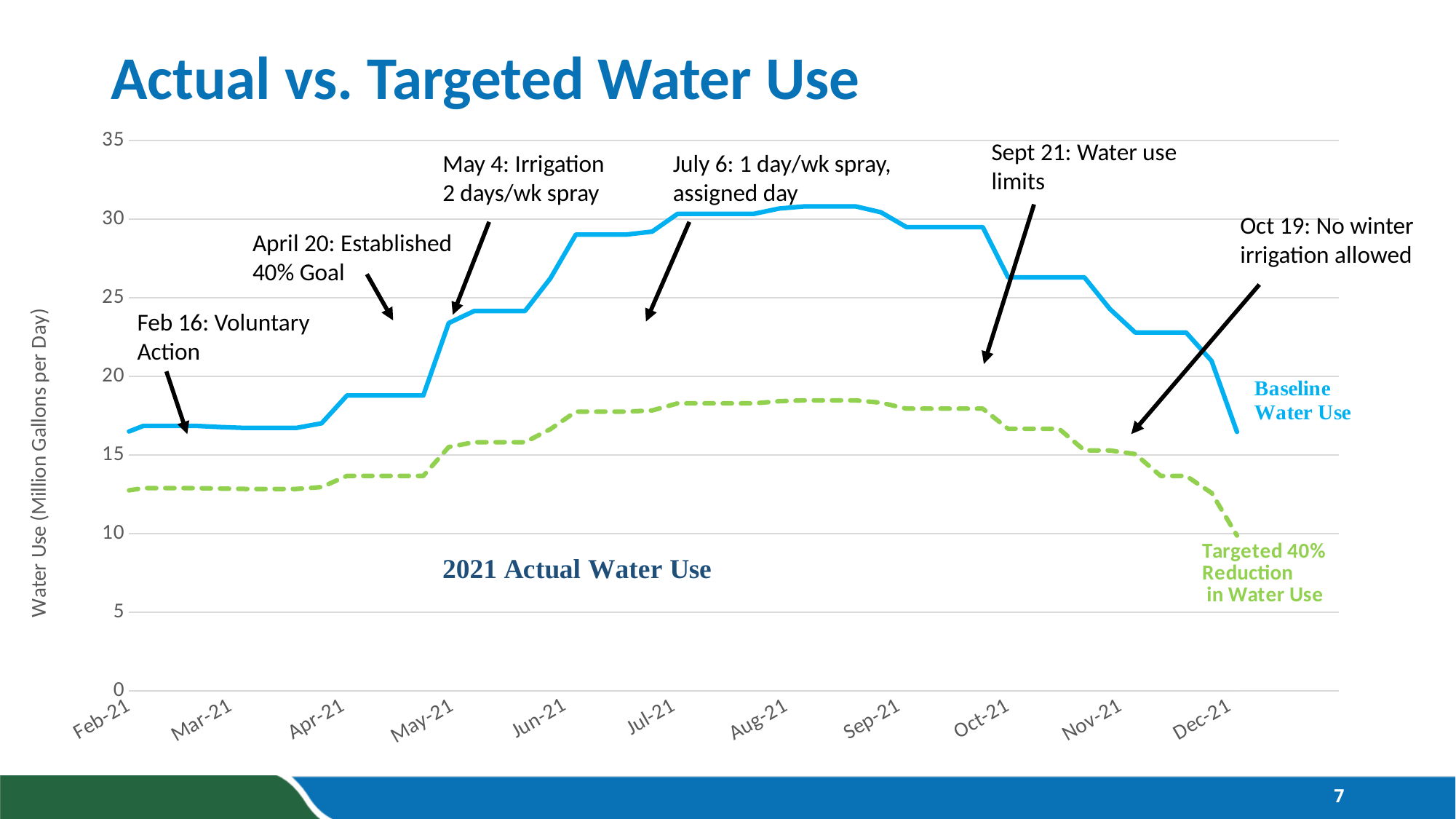
Is the Baseline Water Use value at Aug-21 greater or less than 30? greater What is the title of the chart on the slide? Actual vs. Targeted Water Use Is the Baseline Water Use value at Feb-21 greater or less than 20? less What is the label on the vertical axis of the chart? Water Use (Million Gallons per Day) Is the Baseline Water Use value at Dec-21 greater or less than 20? less What kind of chart is shown on the slide? line chart Does the Baseline Water Use line rise or fall between Feb-21 and Aug-21? rise How many months are labelled along the x axis of the chart? 11 Around which month does the Baseline Water Use line reach its highest point? Aug-21 At Jul-21, which line is higher: Baseline Water Use or Targeted 40% Reduction in Water Use? Baseline Water Use